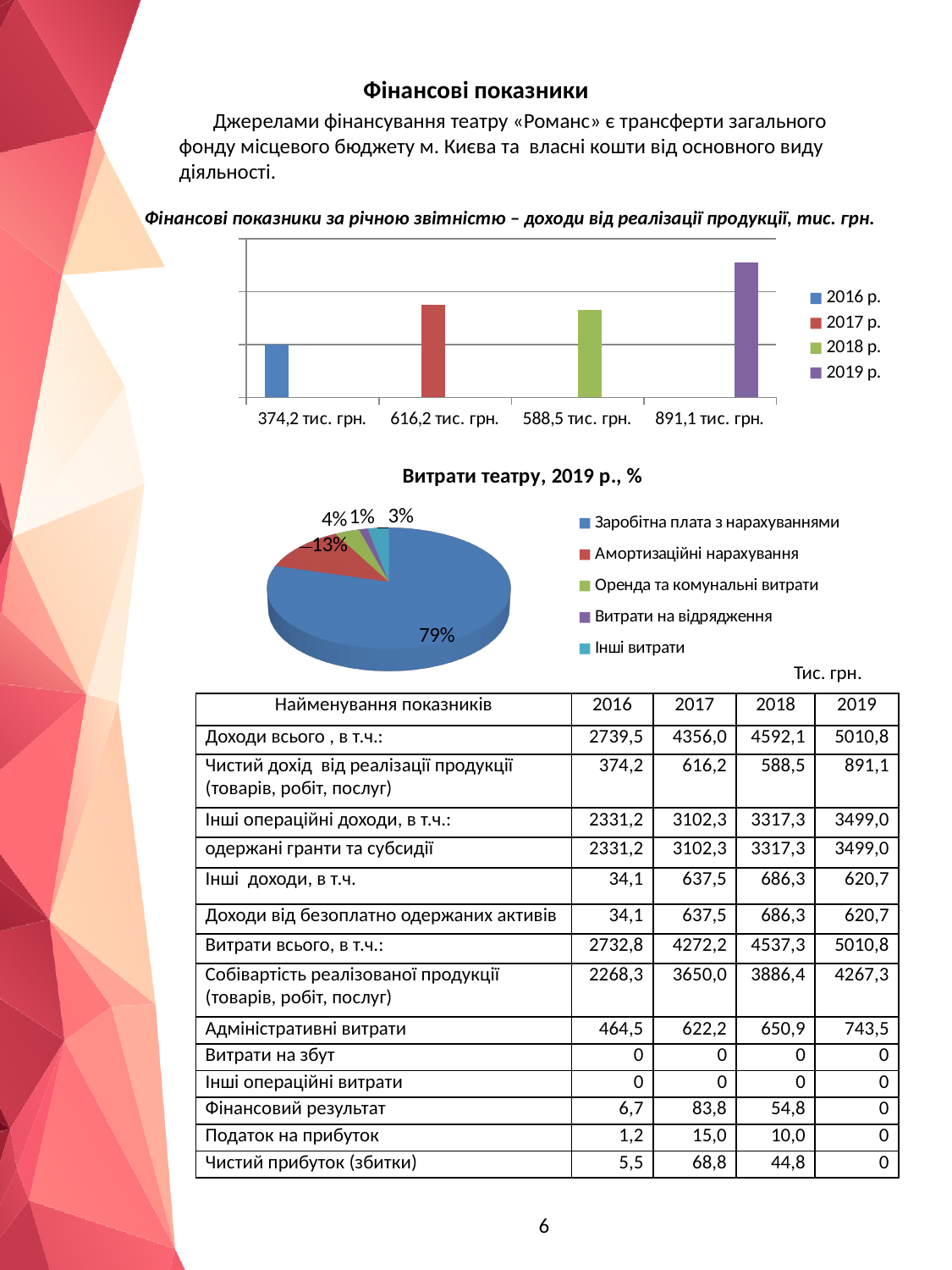
In the bar chart of revenue from sales, which year has the lowest value? 2016 р. In the bar chart of revenue from sales, what is the value for 2016 р.? 374,2 тис. грн. In the pie chart 'Витрати театру, 2019 р., %', what share is Амортизаційні нарахування? 13% In the bar chart of revenue from sales, which year has the highest value? 2019 р. What type of chart is the chart titled 'Витрати театру, 2019 р., %'? Pie chart In the bar chart of revenue from sales, what is the difference between the 2019 р. value and the 2016 р. value? 516,9 тис. грн. In the bar chart of revenue from sales, which is larger: the value for 2017 р. or for 2018 р.? 2017 р. How many categories does the legend of the pie chart 'Витрати театру, 2019 р., %' list? 5 In the pie chart 'Витрати театру, 2019 р., %', which category has the smallest share? Витрати на відрядження In the bar chart of revenue from sales (доходи від реалізації продукції), what is the value for 2019 р.? 891,1 тис. грн. In the pie chart 'Витрати театру, 2019 р., %', what share is Заробітна плата з нарахуваннями? 79% How many series does the legend of the bar chart of revenue from sales list? 4